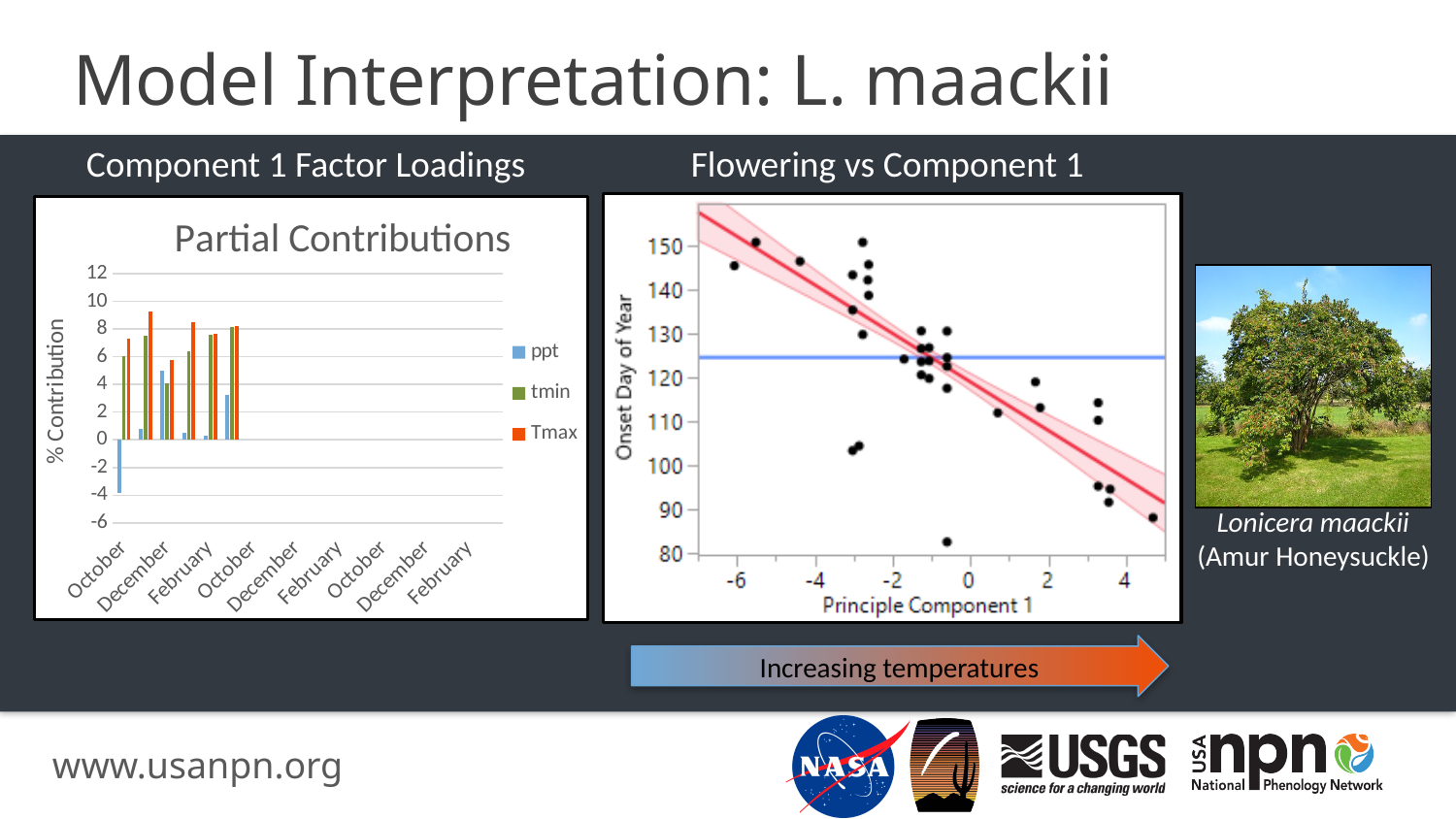
In the Partial Contributions chart, is the Tmax value for the first December greater or less than 8? less In the Partial Contributions chart, which series has the single tallest bar? Tmax What are the legend entries of the Partial Contributions chart? ppt, tmin, Tmax In the Partial Contributions chart, which series has the lowest bar? ppt What kind of chart is the Partial Contributions chart on the left? bar chart In the Partial Contributions chart, is the ppt value for the first February greater or less than 4? less How many series does the legend of the Partial Contributions chart list? 3 In the Partial Contributions chart, is the ppt value for the first October greater or less than 0? less What kind of chart is the Flowering vs Component 1 chart on the right? scatter plot In the Partial Contributions chart, for the first October, which is larger: tmin or Tmax? Tmax How many category labels are shown on the x axis of the Partial Contributions chart? 9 In the Flowering vs Component 1 chart, does Onset Day of Year rise or fall as Principle Component 1 increases? fall